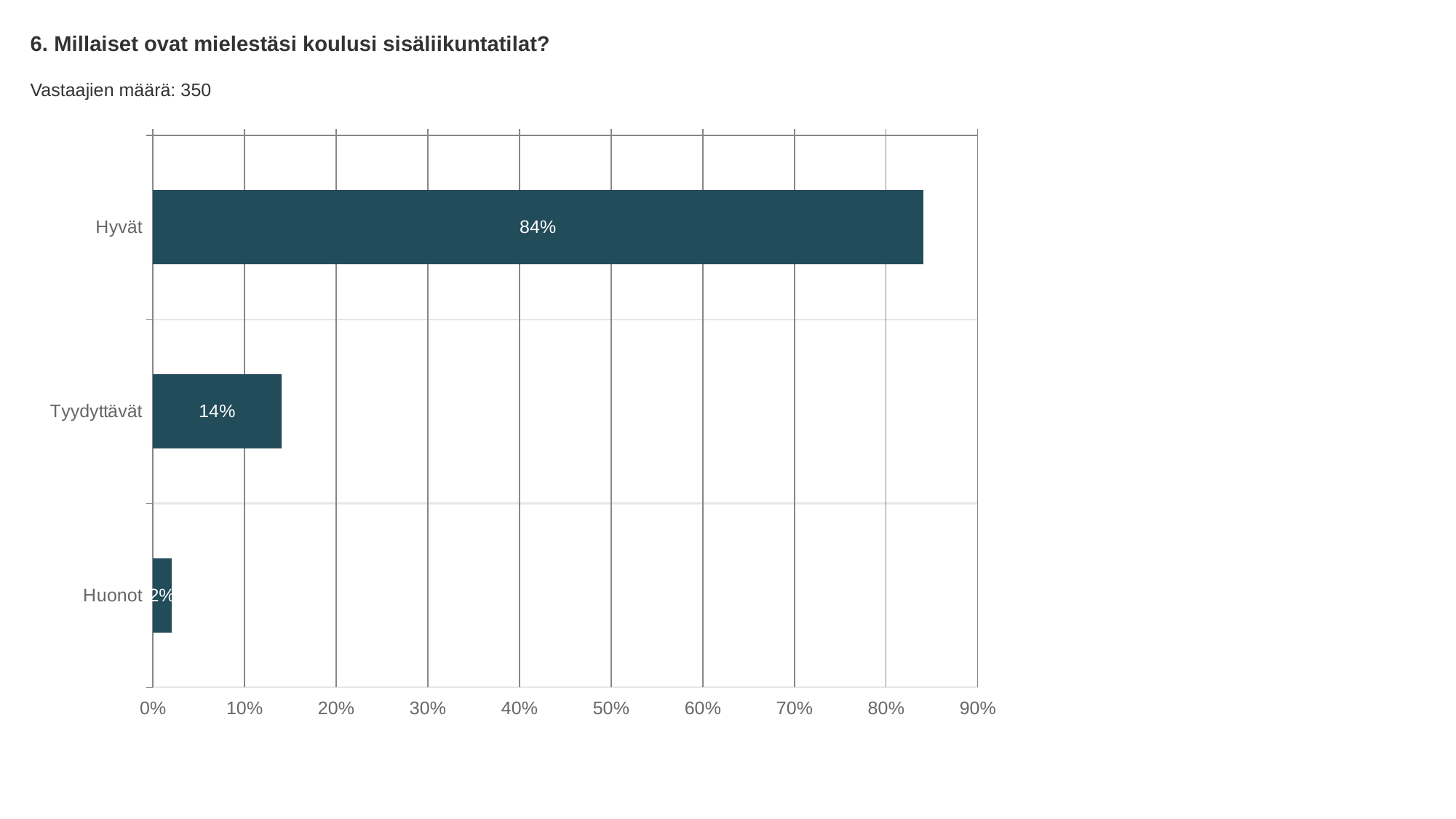
What is the value for Hyvät? 84% How many categories are shown in the chart? 3 What kind of chart is shown on the slide? bar chart What is the difference between the values for Hyvät and Tyydyttävät? 70% Which category has the highest value? Hyvät What is the value for Huonot? 2% Which is larger, the value for Tyydyttävät or the value for Huonot? Tyydyttävät What is the value for Tyydyttävät? 14% What is the difference between the values for Tyydyttävät and Huonot? 12% Which category has the lowest value? Huonot Is the value for Hyvät greater or less than 80%? greater How many respondents (Vastaajien määrä) are reported on the slide? 350